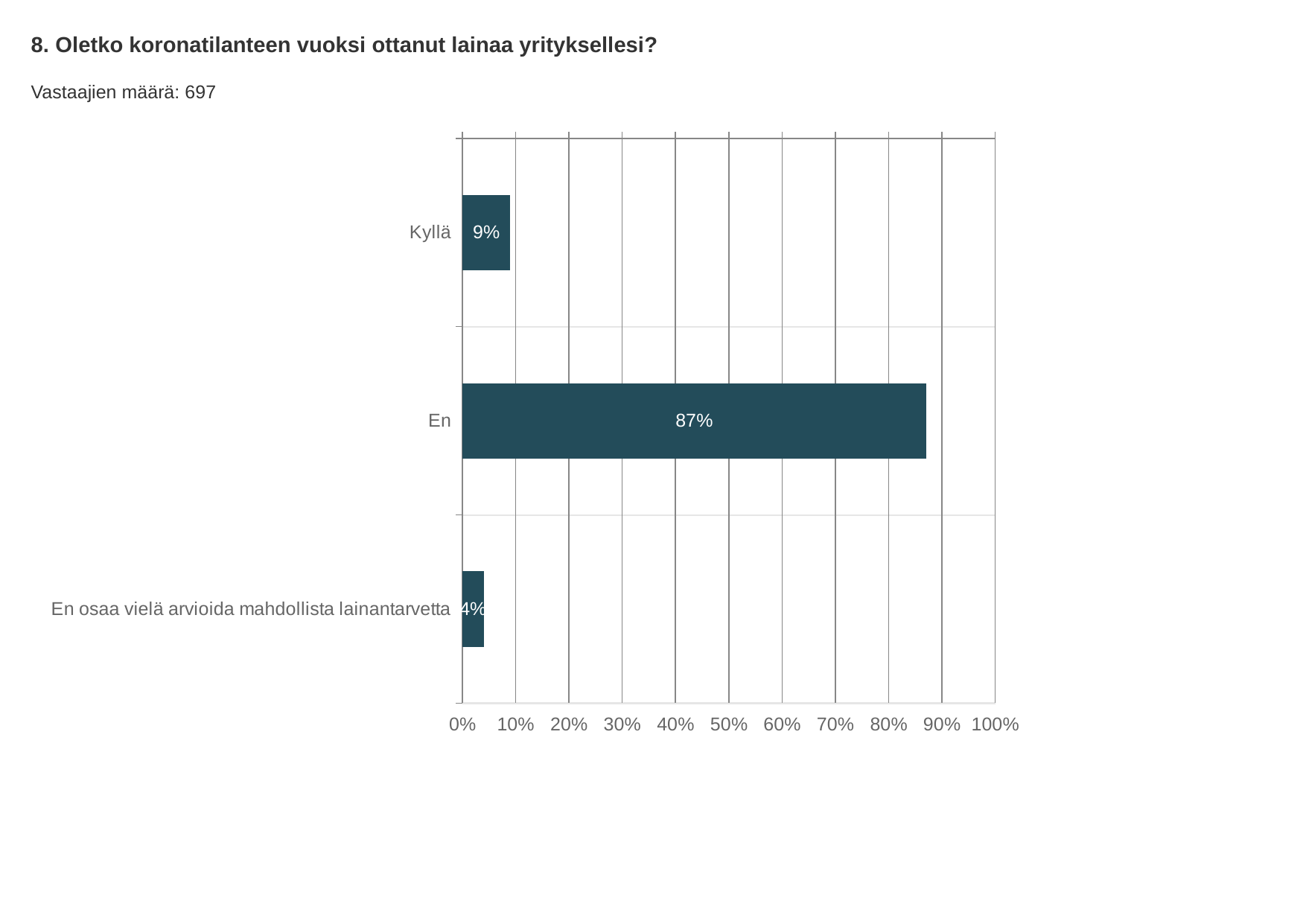
What kind of chart is shown on the slide? bar chart How many categories are shown in the chart? 3 Is the value for "En" greater or less than 80%? greater Which is larger, the value for "Kyllä" or the value for "En"? En Which category has the lowest value? En osaa vielä arvioida mahdollista lainantarvetta How many respondents (Vastaajien määrä) are reported on the slide? 697 What is the difference between the values for "Kyllä" and "En osaa vielä arvioida mahdollista lainantarvetta"? 5% Which category has the highest value? En What is the value for "Kyllä"? 9% What is the value for "En osaa vielä arvioida mahdollista lainantarvetta"? 4% What is the value for "En"? 87% What is the difference between the values for "En" and "Kyllä"? 78%